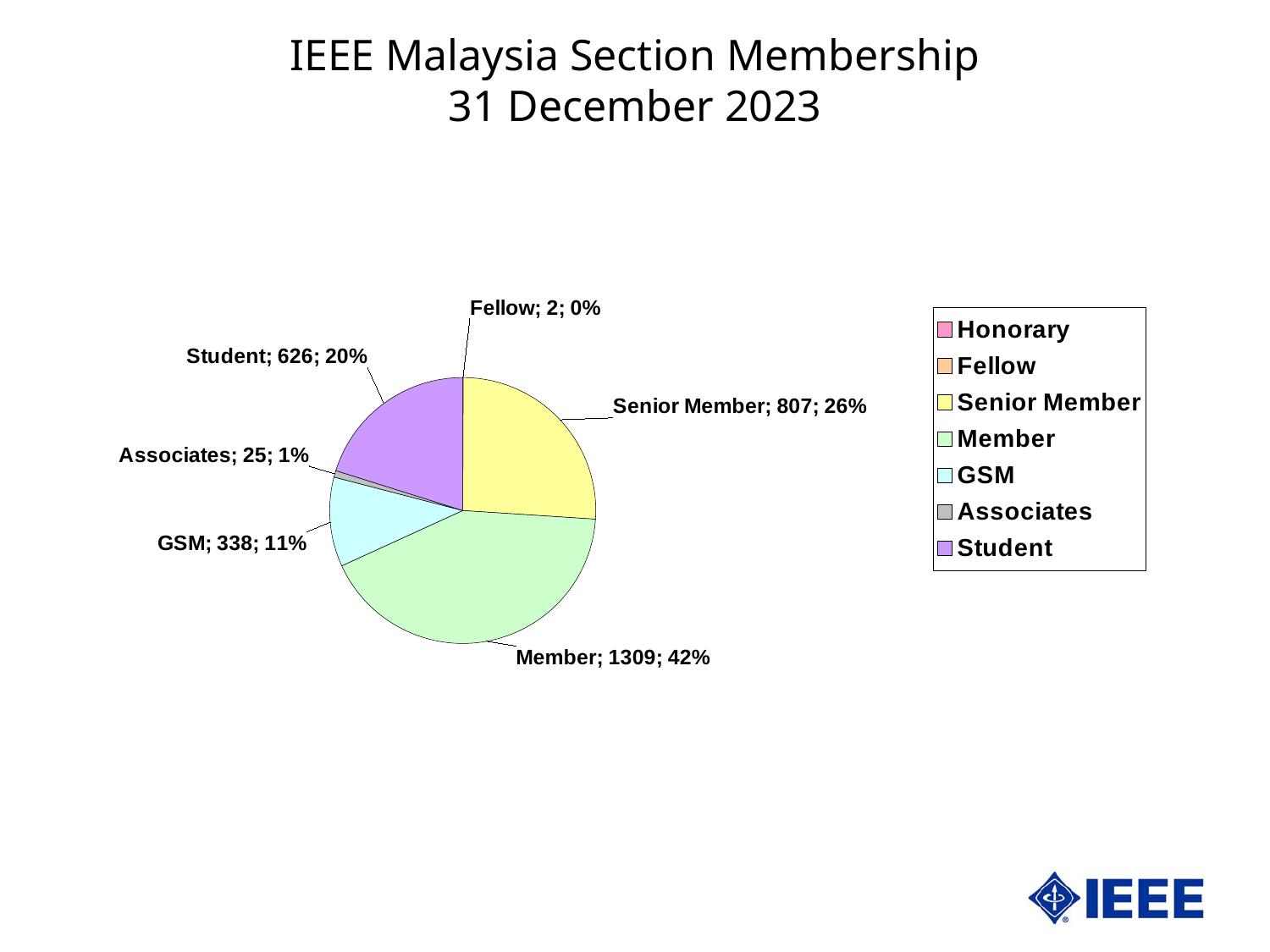
What share of the pie does GSM represent? 11% Which labelled category has the smallest count? Fellow What type of chart is shown on the slide? pie chart What is the difference between the Member count and the Senior Member count? 502 How many entries does the legend list? 7 What is the title of the chart? IEEE Malaysia Section Membership 31 December 2023 How many Senior Members are shown? 807 How many Fellows are shown on the chart? 2 Which category has the largest slice of the pie? Member How many members are in the Member category? 1309 Which is larger, the Student count or the GSM count? Student What percentage of the membership is Student? 20%